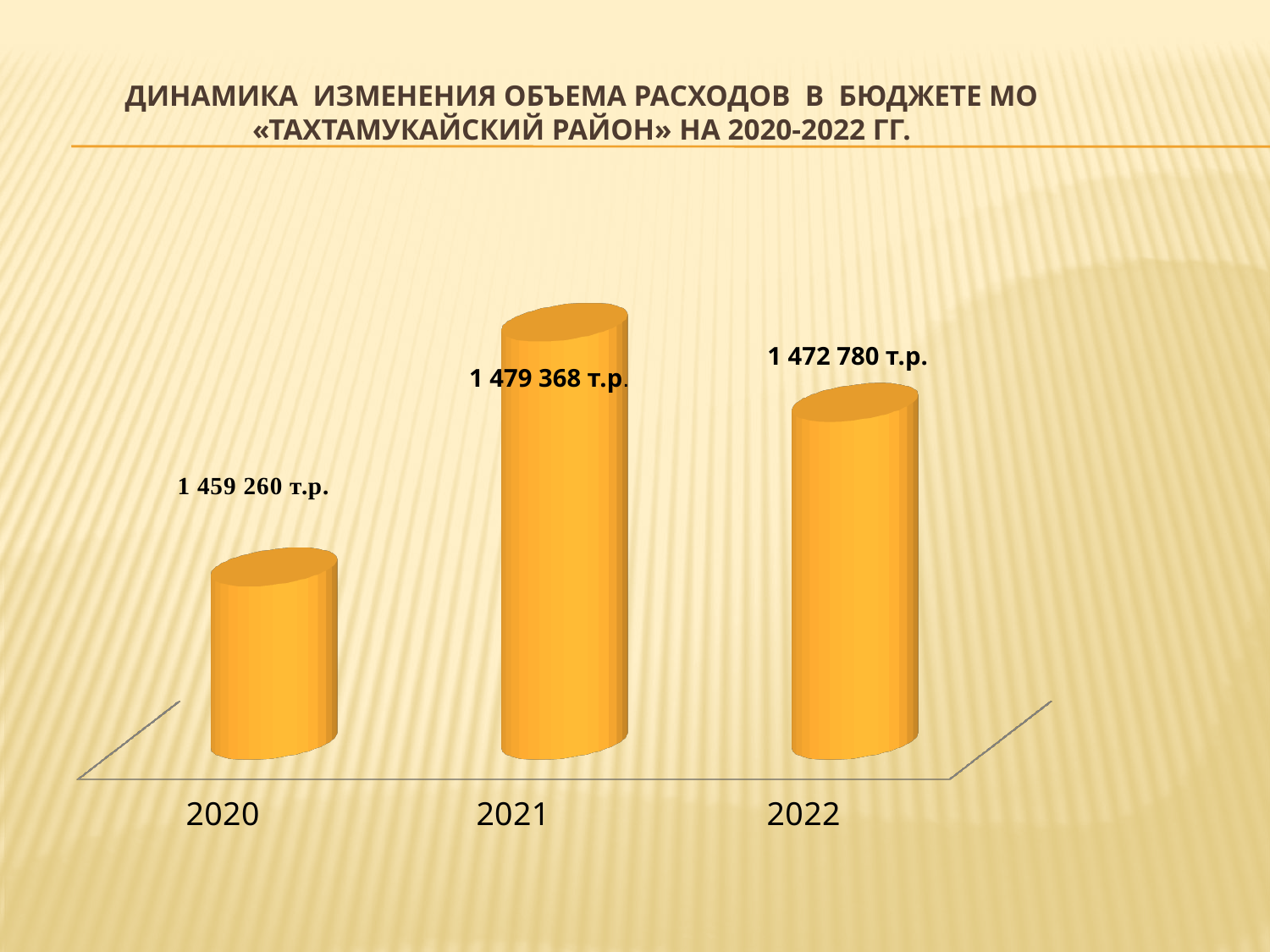
What is the value for 2020? 1 459 260 т.р. What is the difference between the values for 2021 and 2022? 6 588 т.р. Which year has the highest value? 2021 Which year has the lowest value? 2020 Do the values rise or fall from 2021 to 2022? Fall What is the difference between the values for 2022 and 2020? 13 520 т.р. What kind of chart is shown on the slide? Bar chart How many years are shown on the chart? 3 What is the value for 2021? 1 479 368 т.р. Which is larger, the value for 2022 or the value for 2020? 2022 What is the value for 2022? 1 472 780 т.р. What is the difference between the values for 2021 and 2020? 20 108 т.р.